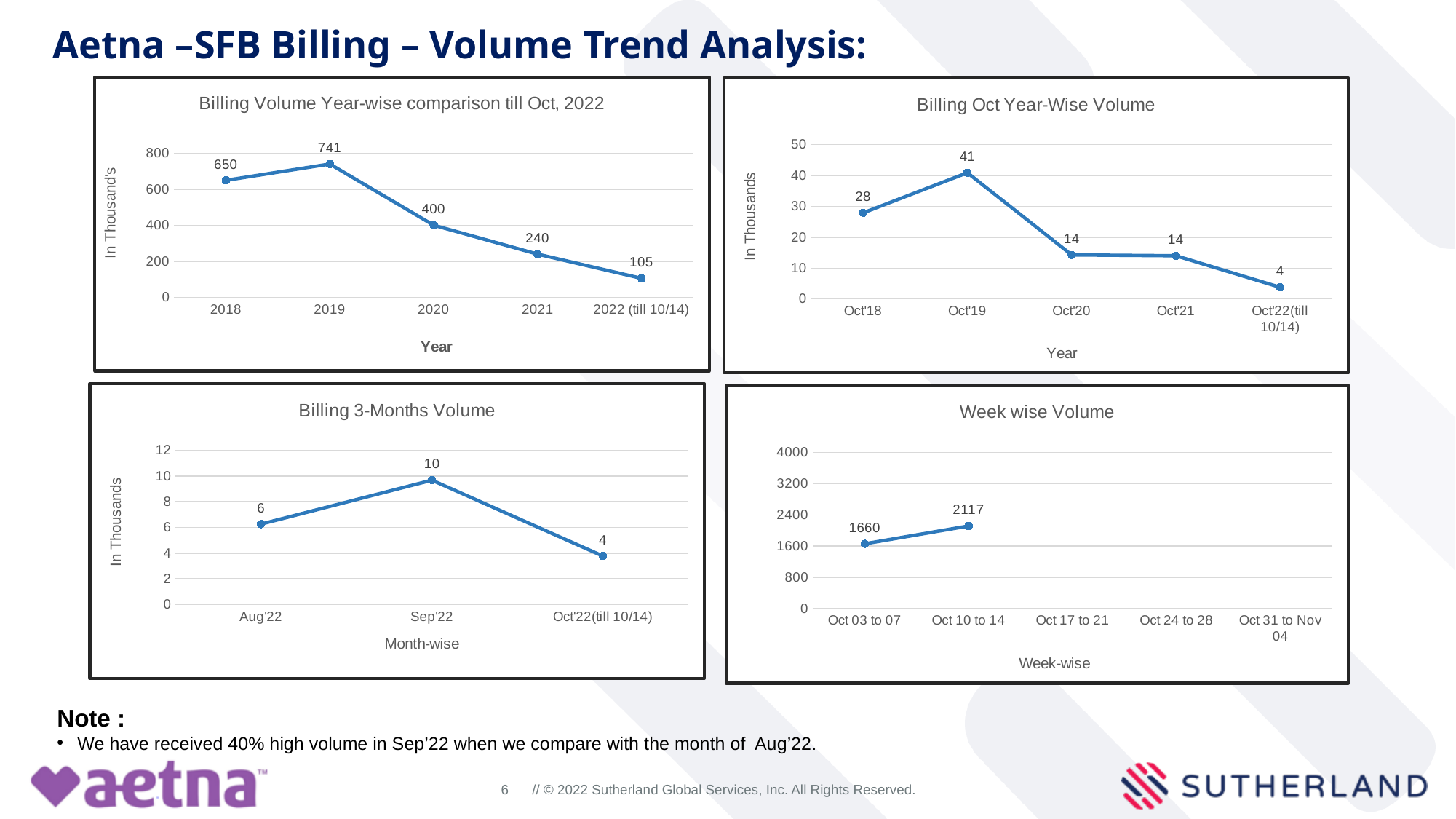
In the 'Billing Oct Year-Wise Volume' chart, which category has the highest value? Oct'19 In the 'Billing Volume Year-wise comparison till Oct, 2022' chart, what is the difference between the values for 2019 and 2020? 341 In the 'Billing Volume Year-wise comparison till Oct, 2022' chart, which year has the lowest value? 2022 (till 10/14) In the 'Billing Volume Year-wise comparison till Oct, 2022' chart, do the values rise or fall from 2019 to 2022 (till 10/14)? Fall In the 'Week wise Volume' chart, what is the value for Oct 10 to 14? 2117 In the 'Billing Volume Year-wise comparison till Oct, 2022' chart, what is the value for 2019? 741 In the 'Week wise Volume' chart, what is the difference between the values for Oct 10 to 14 and Oct 03 to 07? 457 In the 'Billing Oct Year-Wise Volume' chart, what is the value for Oct'19? 41 What kind of chart is the 'Week wise Volume' chart? Line chart In the 'Billing 3-Months Volume' chart, what is the value for Sep'22? 10 In the 'Billing 3-Months Volume' chart, which is larger, the value for Aug'22 or the value for Oct'22(till 10/14)? Aug'22 In the 'Billing Oct Year-Wise Volume' chart, how many data points are plotted? 5